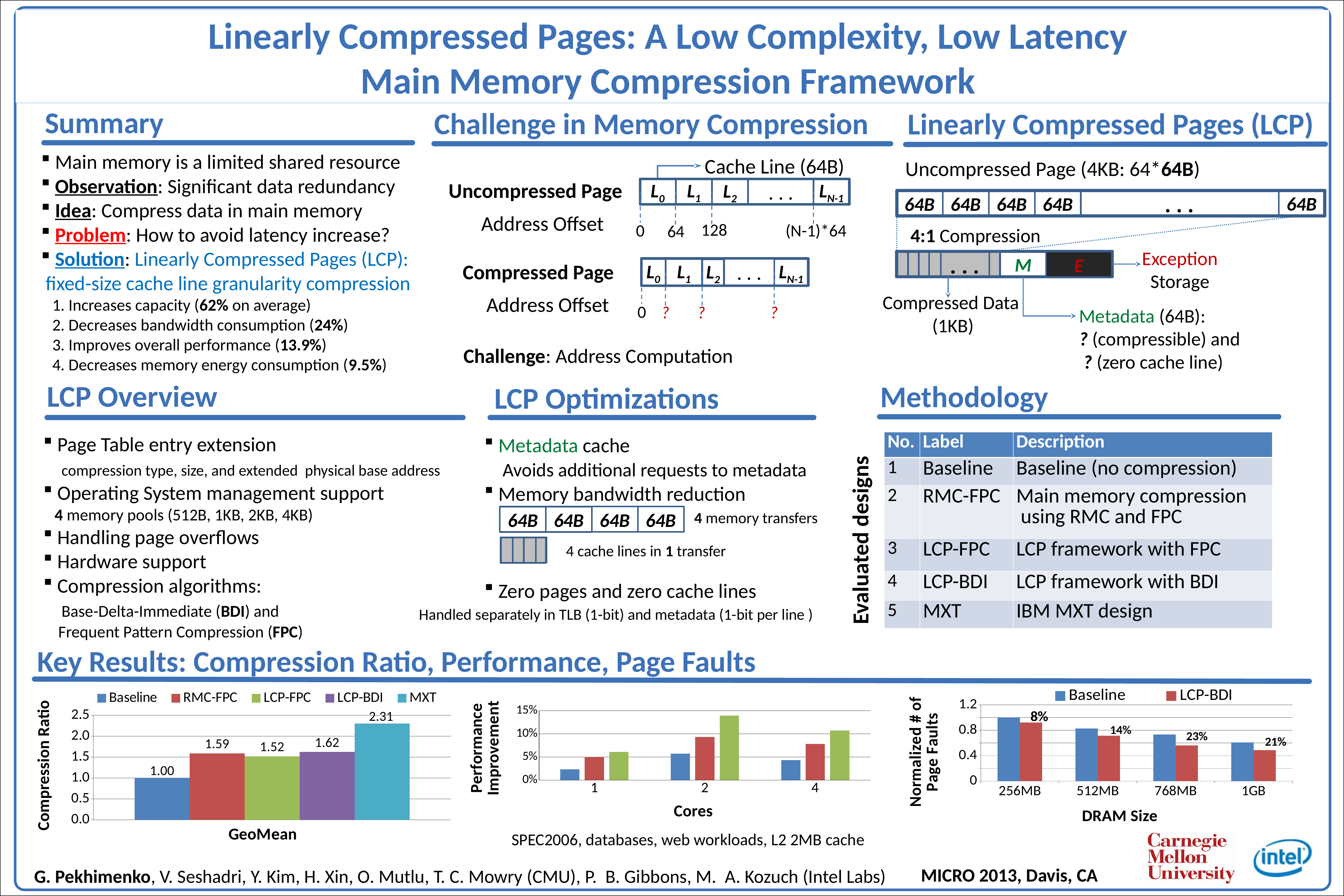
In the Compression Ratio chart, which has a higher compression ratio, RMC-FPC or LCP-FPC? RMC-FPC In the Compression Ratio chart, what is the difference between the compression ratios of LCP-BDI and LCP-FPC? 0.10 In the Compression Ratio chart, how many series does the legend list? 5 In the Compression Ratio chart, what is the compression ratio for LCP-BDI? 1.62 In the Performance Improvement chart, is the value of the green bar at 2 cores greater or less than 10%? greater In the Normalized # of Page Faults chart, is the Baseline value at 1GB greater or less than 0.8? less In the Normalized # of Page Faults chart, how many series does the legend list? 2 What type of chart is the Compression Ratio chart? Bar chart In the Compression Ratio chart, what is the compression ratio for MXT? 2.31 In the Performance Improvement chart, how many core counts are shown on the x axis? 3 In the Compression Ratio chart, which design has the lowest compression ratio? Baseline In the Compression Ratio chart, which design has the highest compression ratio? MXT